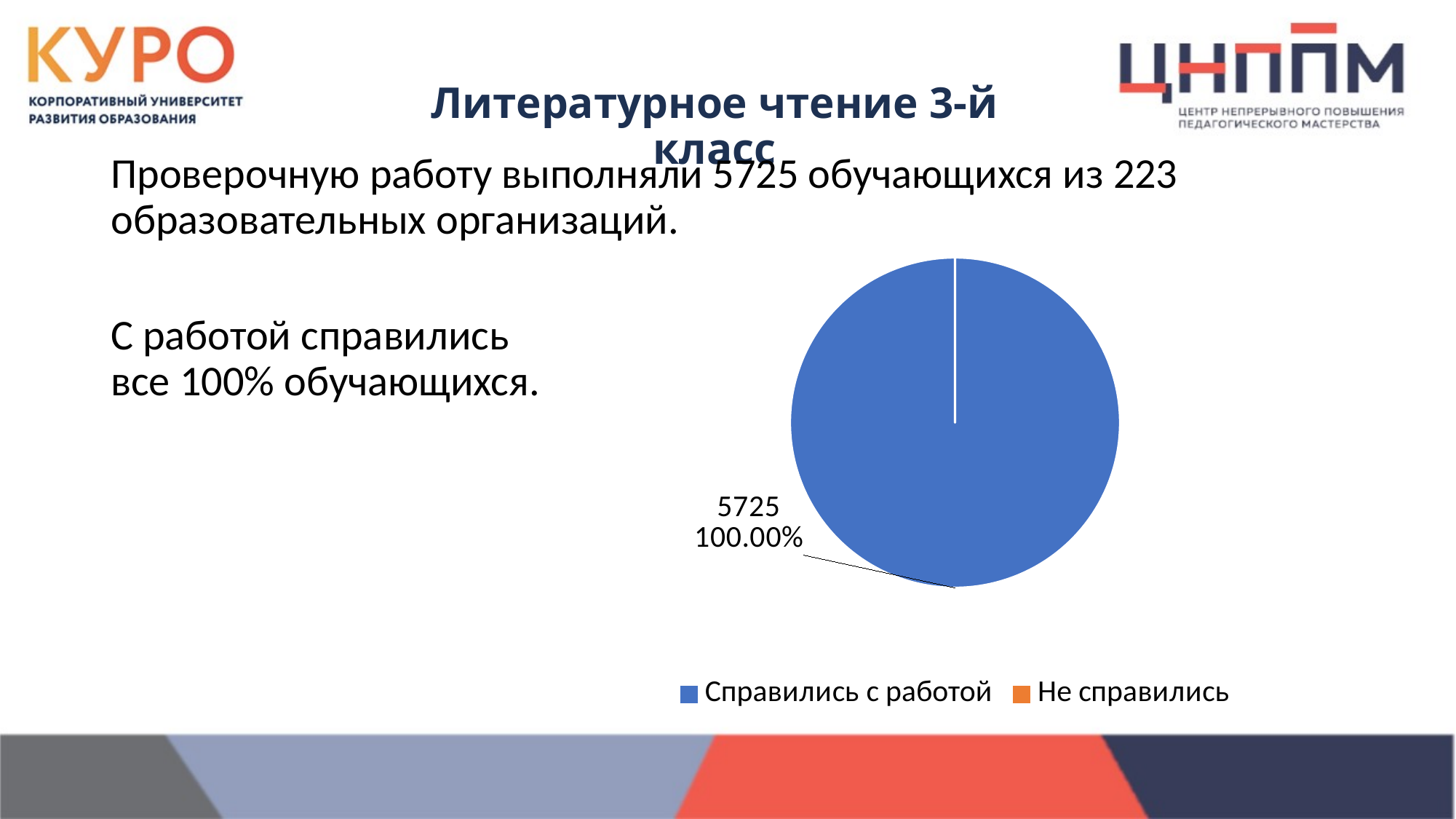
How many entries does the chart legend list? 2 Is the value for "Справились с работой" greater or less than 5000? greater Which is larger in the pie chart: "Справились с работой" or "Не справились"? Справились с работой Which category makes up the largest share of the pie chart? Справились с работой What share of the pie does the slice "Справились с работой" take? 100.00% Which legend entry is shown in orange in the chart legend? Не справились What value is printed on the data label of the pie chart? 5725 What percentage is printed on the data label of the pie chart? 100.00% What kind of chart is shown on the slide? pie chart Which legend entry corresponds to the blue slice of the pie chart? Справились с работой